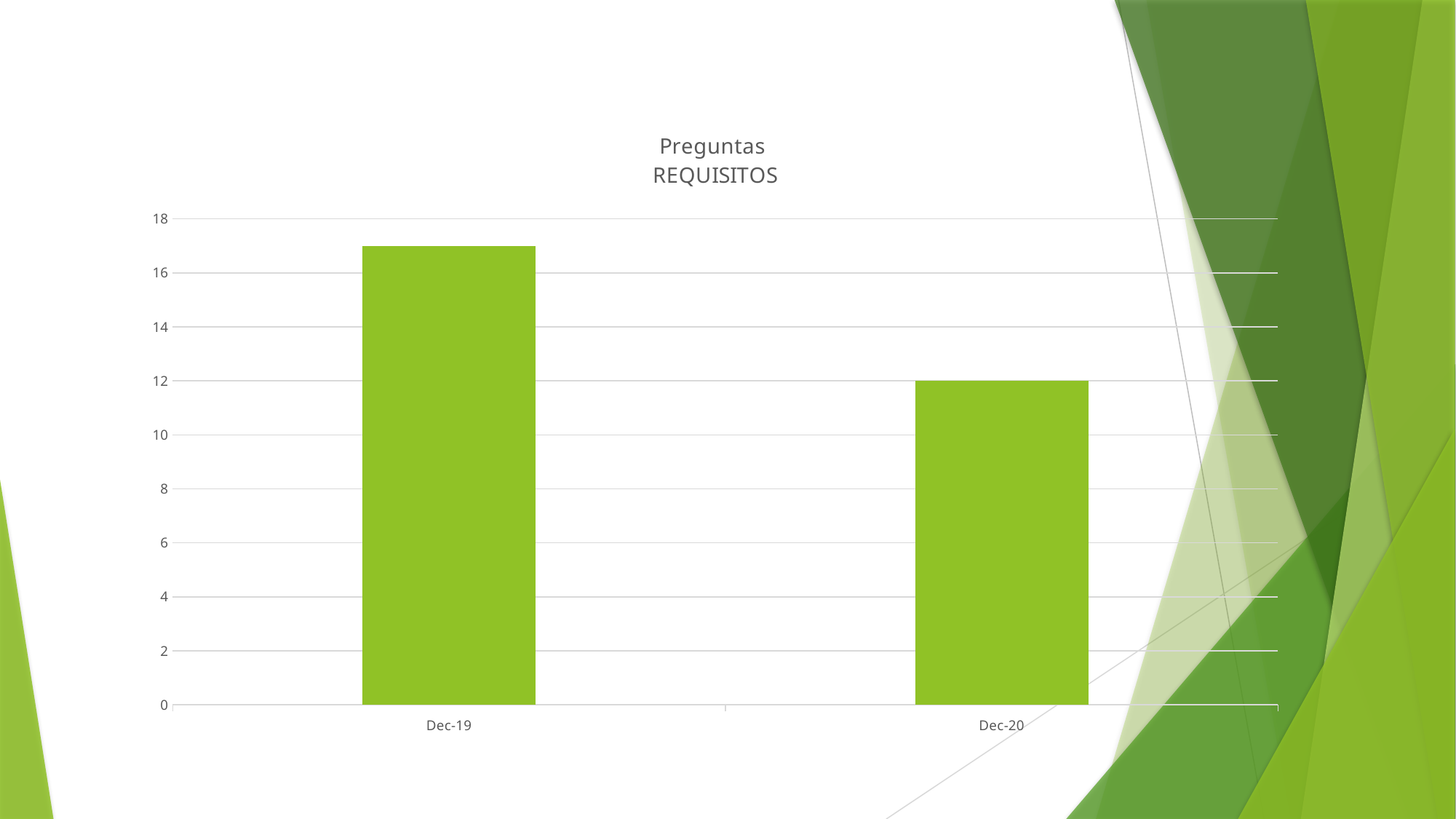
Which category has the highest value in the Preguntas REQUISITOS chart? Dec-19 Is the value for Dec-19 greater or less than 16? greater Which category has the lowest value in the Preguntas REQUISITOS chart? Dec-20 How many categories are shown on the x axis of the Preguntas REQUISITOS chart? 2 What kind of chart is shown on the slide? Bar chart What is the value for Dec-20 in the Preguntas REQUISITOS chart? 12 Is the value for Dec-20 greater or less than 14? less Do the values rise or fall from Dec-19 to Dec-20 in the Preguntas REQUISITOS chart? Fall What is the title of the chart on the slide? Preguntas REQUISITOS Is the value for Dec-19 greater or less than 18? less Which is larger in the Preguntas REQUISITOS chart, the value for Dec-19 or the value for Dec-20? Dec-19 What is the maximum value shown on the vertical axis of the chart? 18